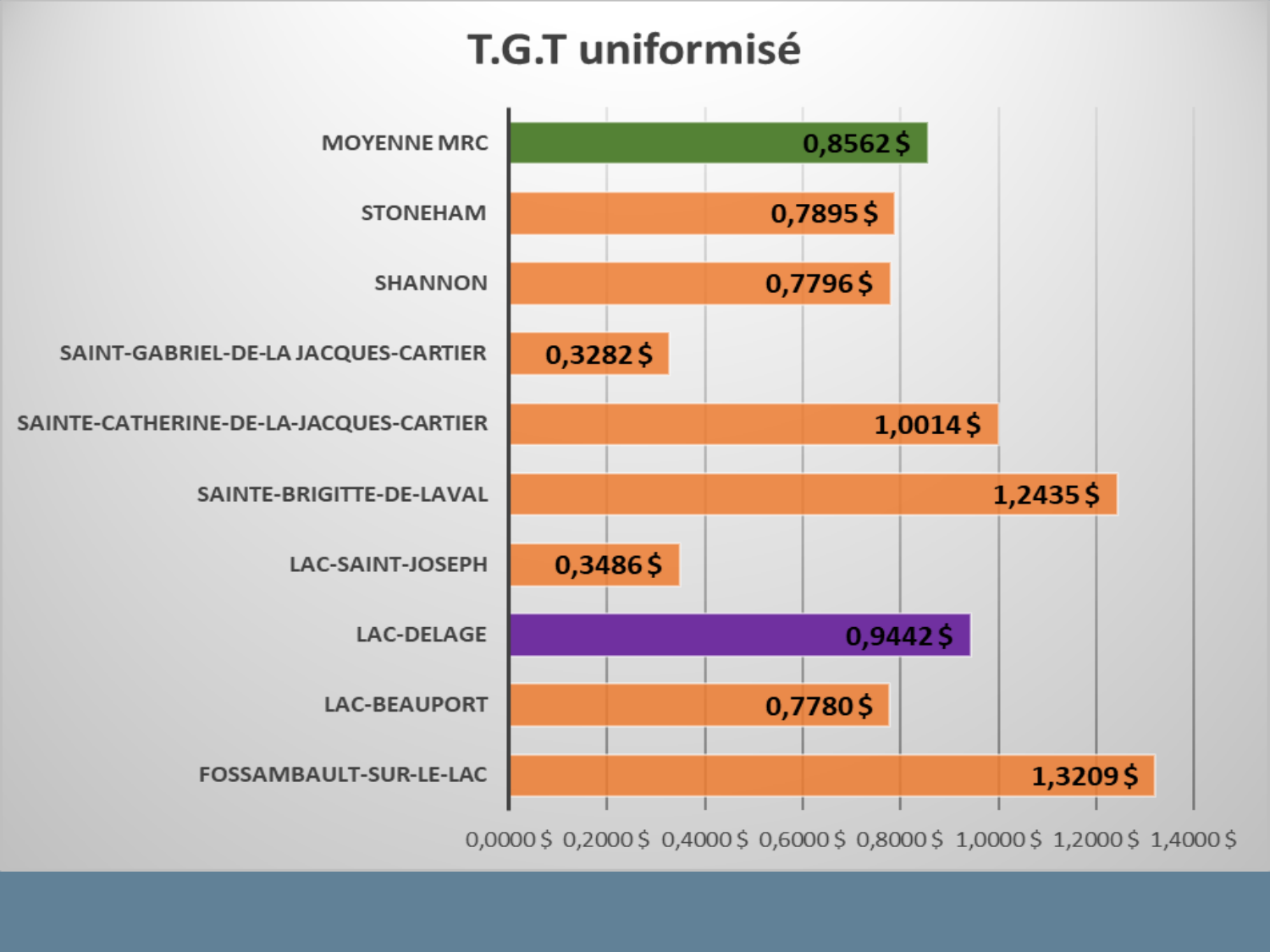
What is the title of the chart? T.G.T uniformisé What is the value for LAC-DELAGE? 0,9442 $ What is the difference between the values for FOSSAMBAULT-SUR-LE-LAC and SAINTE-BRIGITTE-DE-LAVAL? 0,0774 $ What is the value for SAINT-GABRIEL-DE-LA JACQUES-CARTIER? 0,3282 $ How many categories are shown in the chart? 10 What is the value for MOYENNE MRC? 0,8562 $ Which category's bar is coloured purple? LAC-DELAGE Is the value for SAINTE-CATHERINE-DE-LA-JACQUES-CARTIER greater or less than 0,8000 $? greater Which is larger, the value for LAC-DELAGE or the value for MOYENNE MRC? LAC-DELAGE Which category has the highest value? FOSSAMBAULT-SUR-LE-LAC Which category has the lowest value? SAINT-GABRIEL-DE-LA JACQUES-CARTIER What kind of chart is this? bar chart